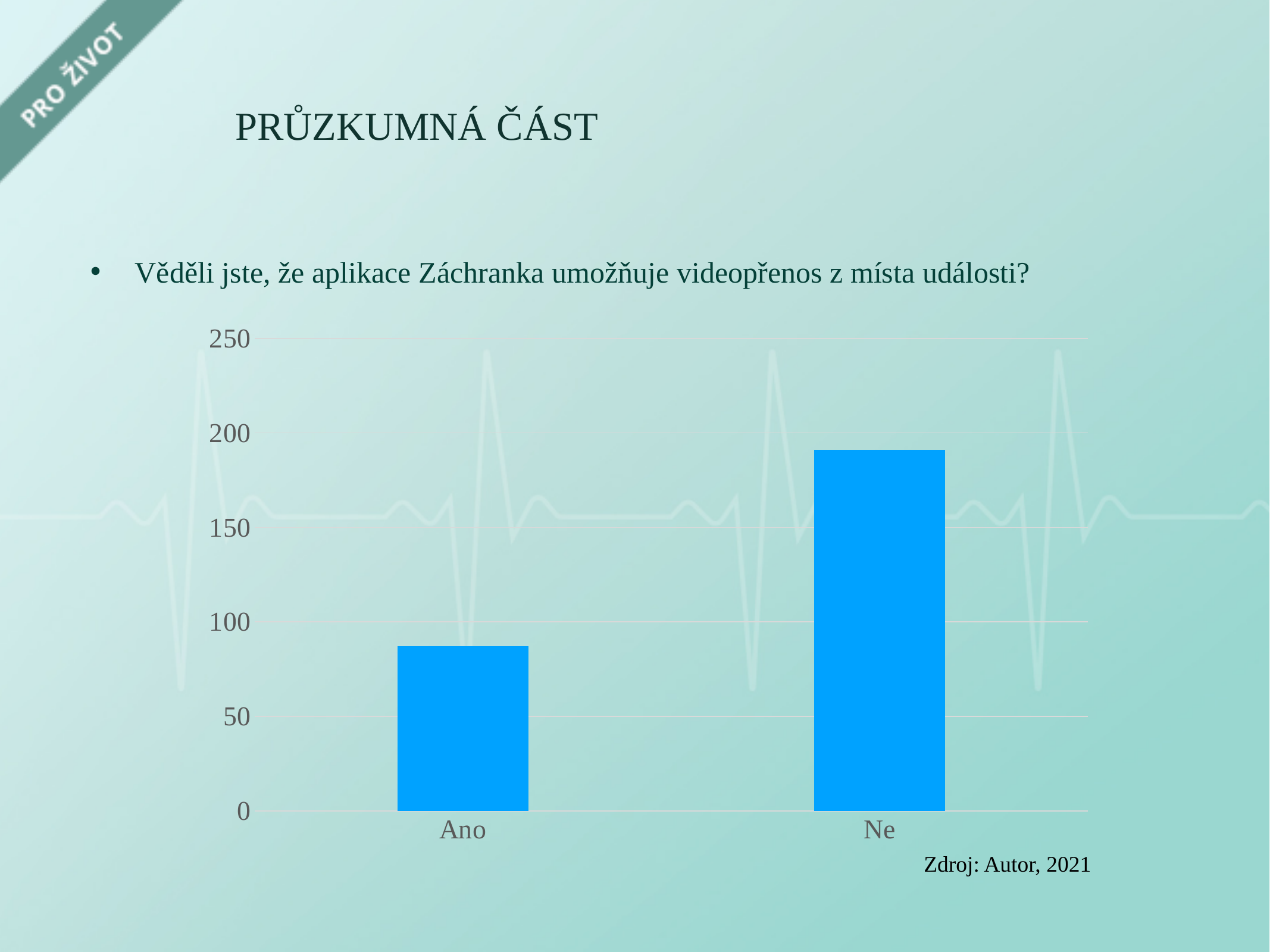
Which bar is taller, Ano or Ne? Ne What kind of chart is shown on the slide? bar chart What is the highest value shown on the y axis of the chart? 250 Is the value for Ne greater or less than 150? greater Is the value for Ne greater or less than 200? less What source is cited below the chart? Zdroj: Autor, 2021 How many categories are shown on the x axis of the chart? 2 Is the value for Ano greater or less than 50? greater Which category has the lowest bar in the chart? Ano Which category has the highest bar in the chart? Ne